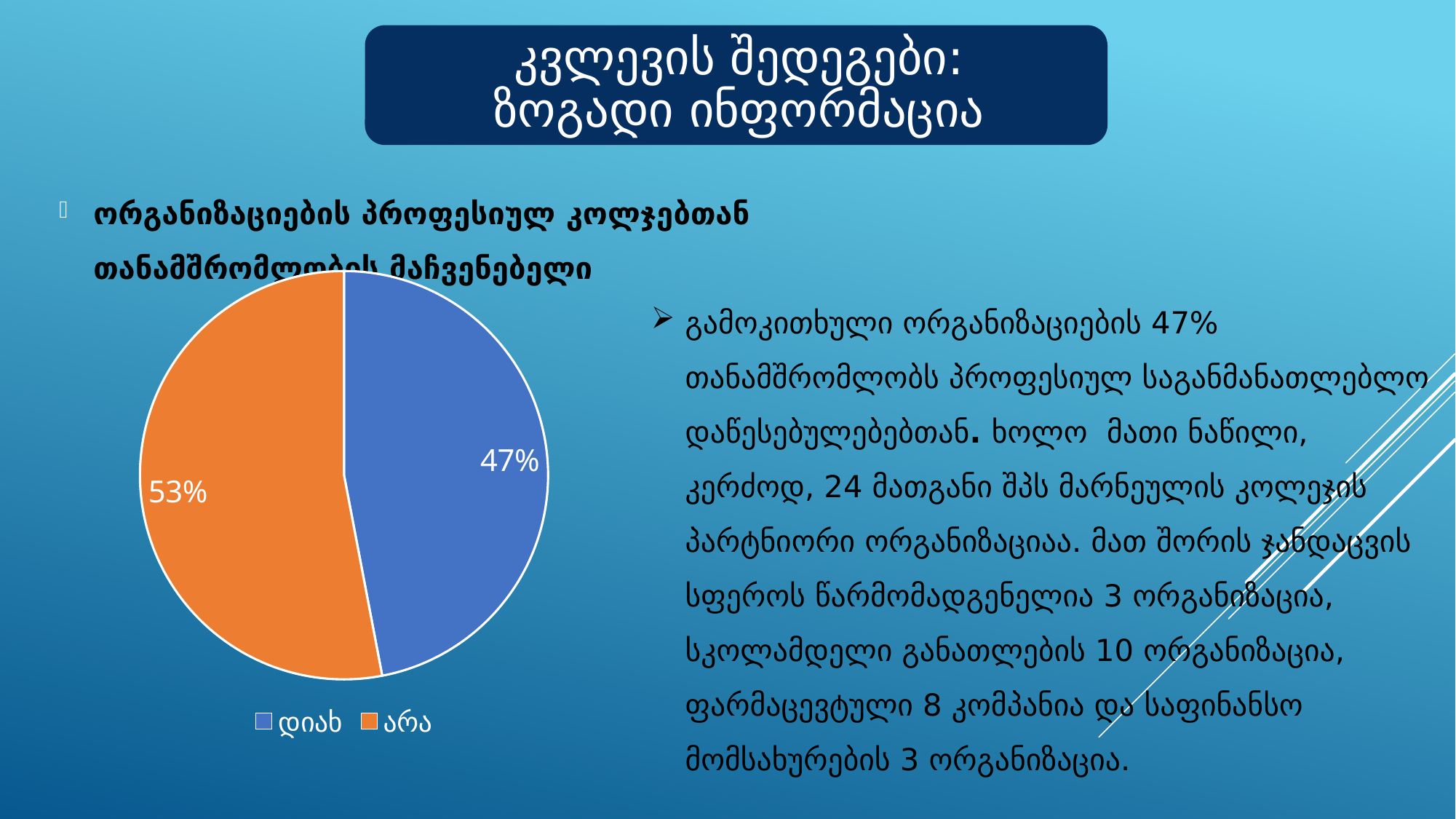
What colour is the "დიახ" slice in the pie chart? Blue What share of the pie does the "დიახ" slice represent? 47% What percentage does the "დიახ" slice of the pie chart show? 47% What colour is the "არა" slice in the pie chart? Orange How many slices does the pie chart have? 2 How many entries does the pie chart legend list? 2 What is the difference in percentage points between the "არა" and "დიახ" slices? 6 What percentage does the "არა" slice of the pie chart show? 53% What kind of chart is shown on the slide? Pie chart Which slice of the pie chart is the smallest? დიახ Which slice of the pie chart is the largest? არა Which is larger in the pie chart, "დიახ" or "არა"? არა